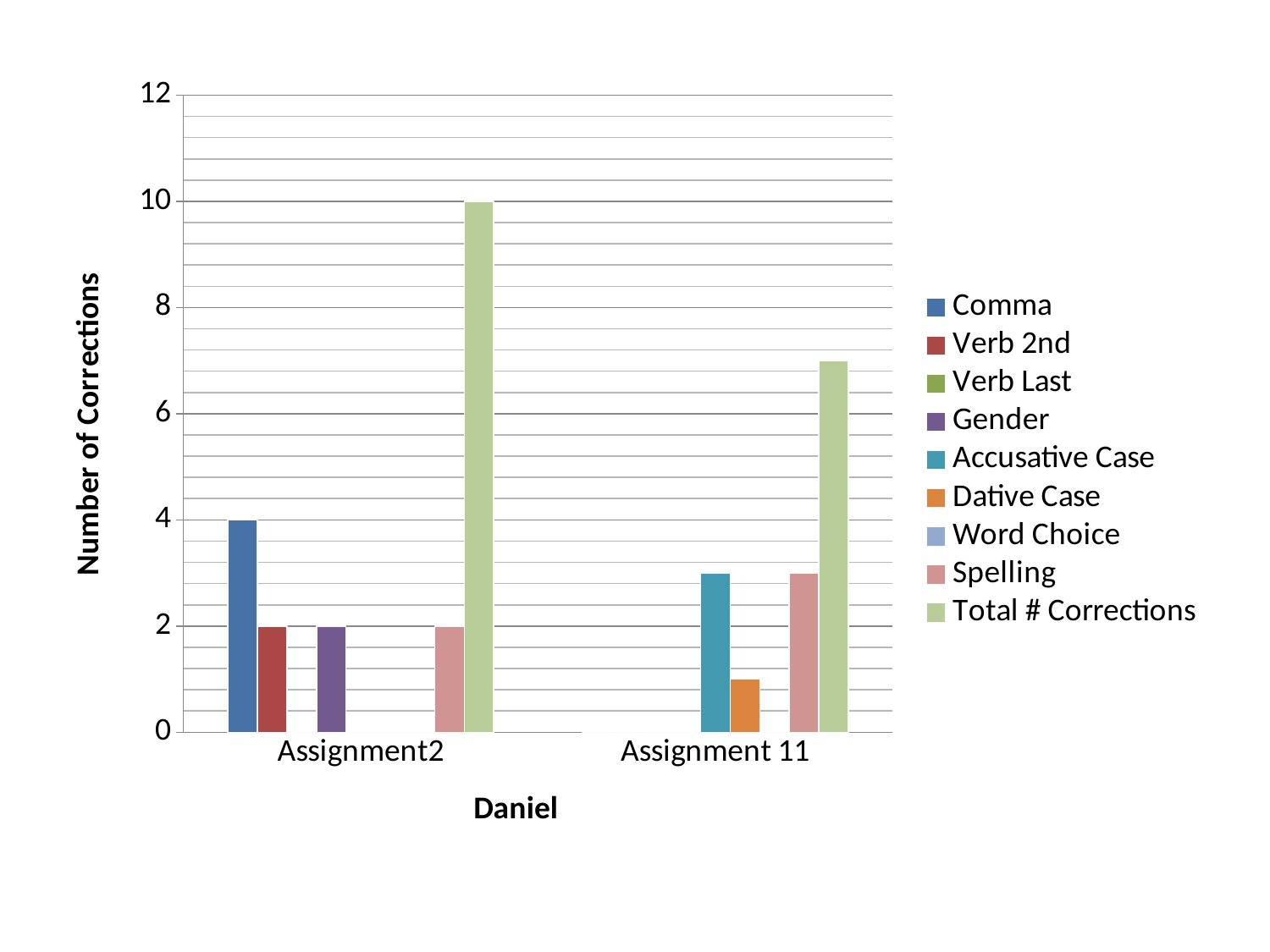
What is the label of the y axis? Number of Corrections What is the Total # Corrections value for Assignment2? 10 How many assignment categories are shown on the x axis? 2 What type of chart is shown on the slide? bar chart Is the Dative Case value for Assignment 11 greater or less than 2? less Is the Total # Corrections value for Assignment 11 greater or less than 6? greater Which is larger: Total # Corrections for Assignment2 or Total # Corrections for Assignment 11? Assignment2 How many series does the legend list? 9 Which series has the highest value for Assignment2? Total # Corrections What is the difference between the Comma value and the Verb 2nd value for Assignment2? 2 What is the Comma value for Assignment2? 4 What is the Gender value for Assignment2? 2